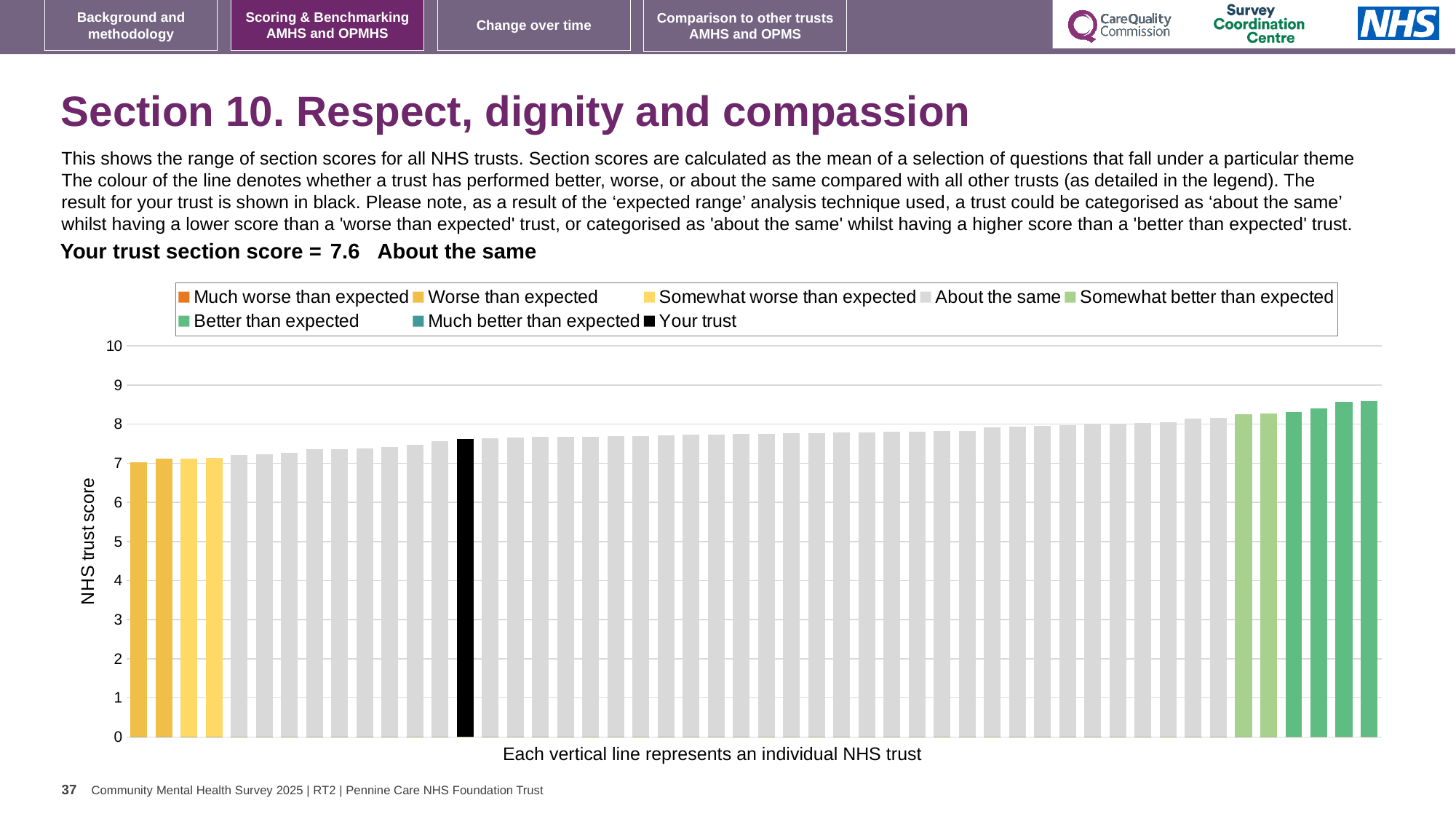
Do the bar values rise or fall from left to right along the x axis? rise How many bars are coloured as 'Better than expected'? 4 How many series does the legend list? 8 What is the label on the y axis? NHS trust score What is the section score for your trust? 7.6 What colour is the bar representing your trust? black Which category is your trust placed in for this section? About the same Is the value for your trust greater or less than 7? greater Is the value of the lowest bar greater or less than 8? less What kind of chart is shown on the slide? bar chart Is the value of the highest bar greater or less than 9? less How many bars are coloured as 'Worse than expected'? 2